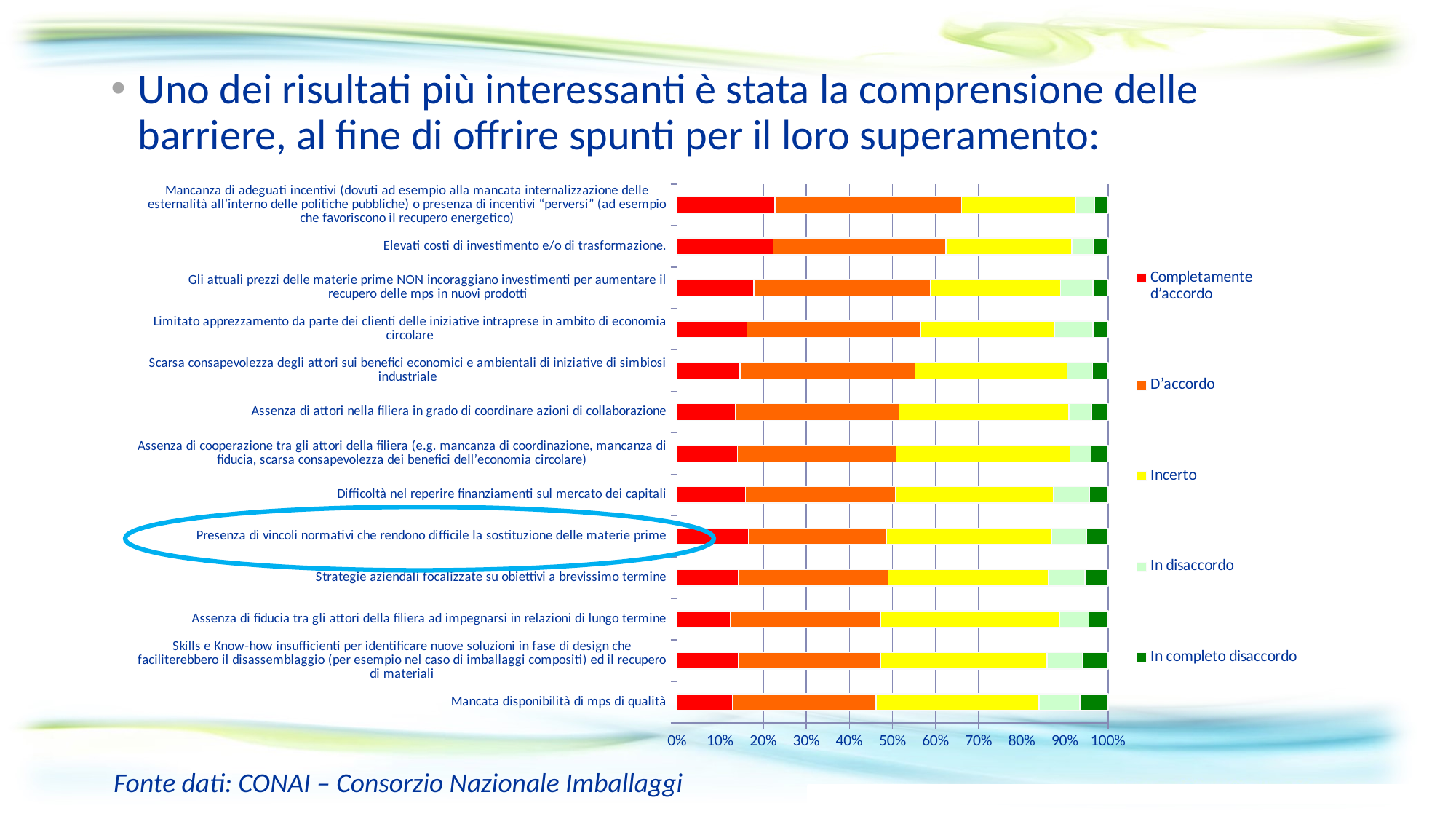
Which has the larger 'Completamente d'accordo' share: 'Mancanza di adeguati incentivi...' or 'Assenza di fiducia tra gli attori della filiera...'? Mancanza di adeguati incentivi... Is the 'Completamente d'accordo' share for 'Mancanza di adeguati incentivi...' greater or less than 20%? greater Is the combined 'Completamente d'accordo' plus 'D'accordo' share for 'Mancata disponibilità di mps di qualità' greater or less than 50%? less Is the combined 'Completamente d'accordo' plus 'D'accordo' share for 'Mancanza di adeguati incentivi...' greater or less than 60%? greater How many barrier categories are plotted in the chart? 13 Which colour represents the 'Incerto' series in the chart? Yellow Which has the larger 'In completo disaccordo' share: 'Mancata disponibilità di mps di qualità' or 'Elevati costi di investimento e/o di trasformazione'? Mancata disponibilità di mps di qualità Which category label is circled on the slide? Presenza di vincoli normativi che rendono difficile la sostituzione delle materie prime What is the total of each stacked bar in the chart? 100% What kind of chart is shown on the slide? Stacked bar chart How many series does the chart legend list? 5